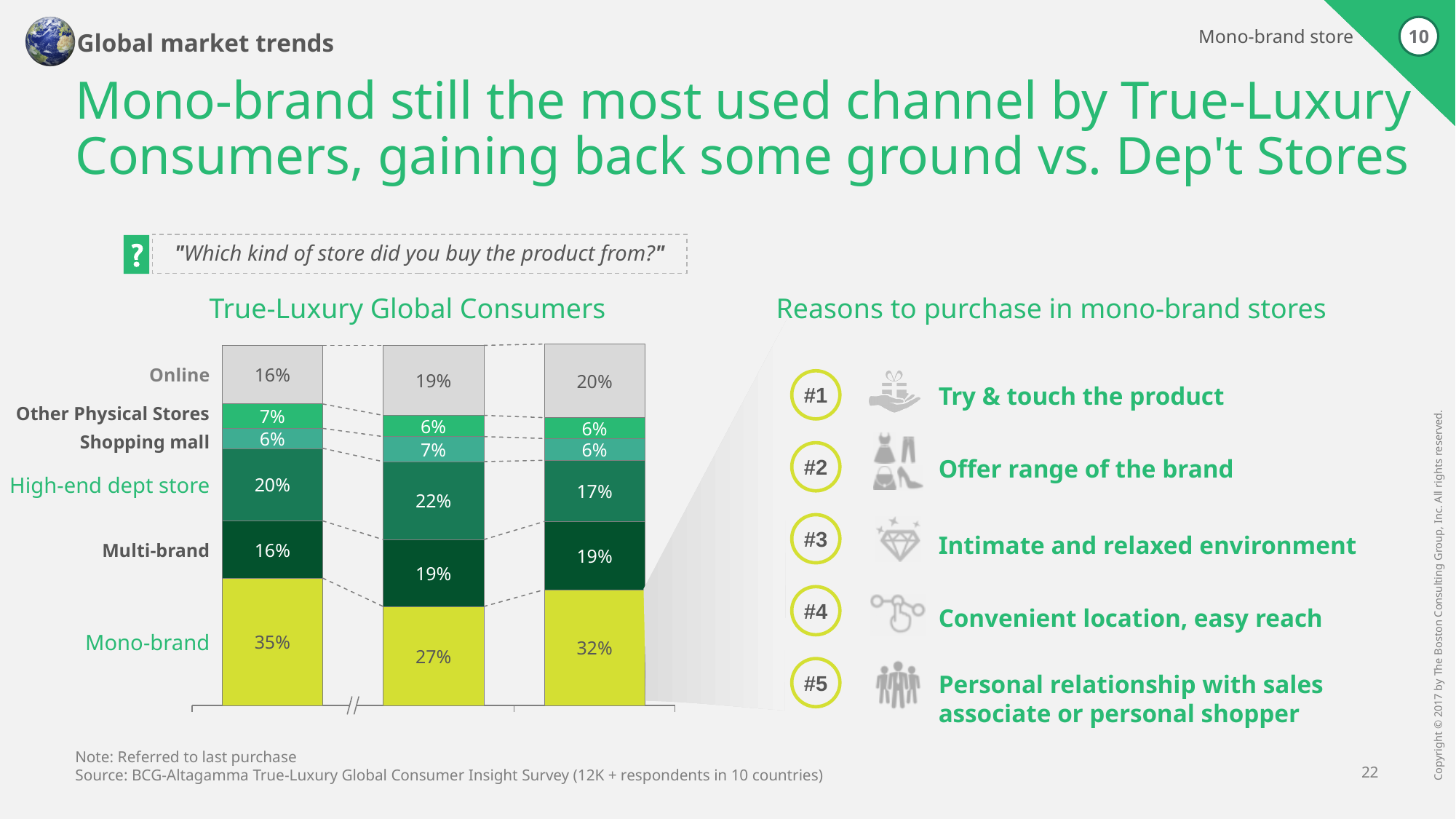
In the True-Luxury Global Consumers chart, what is the High-end dept store share in the middle bar? 22% In the True-Luxury Global Consumers chart, which store type has the largest share in the rightmost bar? Mono-brand In the True-Luxury Global Consumers chart, what is the difference between the Mono-brand share in the leftmost bar and in the middle bar? 8 percentage points In the True-Luxury Global Consumers chart, is the Multi-brand share larger in the leftmost bar or the rightmost bar? Rightmost bar In the True-Luxury Global Consumers chart, what is the Mono-brand share in the leftmost bar? 35% What is the total of the segments in the middle bar of the True-Luxury Global Consumers chart? 100% In the True-Luxury Global Consumers chart, does the Online share rise or fall from the leftmost bar to the rightmost bar? Rise In the True-Luxury Global Consumers chart, which store type has the smallest share in the leftmost bar? Shopping mall What type of chart is used to show the True-Luxury Global Consumers data? Stacked bar chart How many stacked bars are shown in the True-Luxury Global Consumers chart? 3 In the True-Luxury Global Consumers chart, what is the Online share in the rightmost bar? 20% How many store types are stacked in each bar of the True-Luxury Global Consumers chart? 6